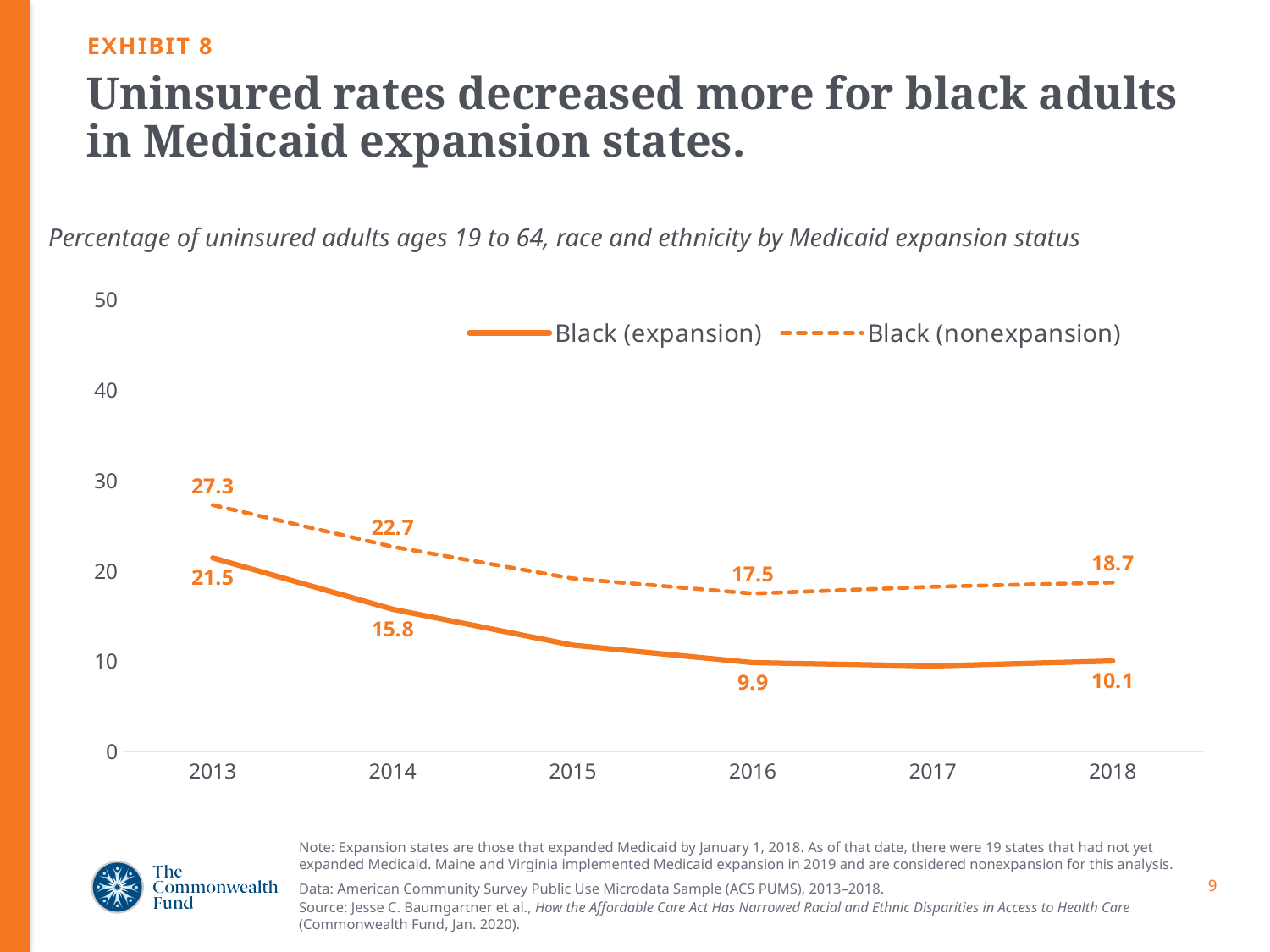
How many series does the legend list? 2 What was the uninsured rate for Black (nonexpansion) in 2014? 22.7 What was the uninsured rate for Black (nonexpansion) in 2018? 18.7 Is the value for Black (expansion) in 2015 greater or less than 20? less What was the uninsured rate for Black (expansion) in 2013? 21.5 In which year was the Black (nonexpansion) rate highest? 2013 How many years are shown on the x axis? 6 What was the uninsured rate for Black (expansion) in 2016? 9.9 What kind of chart is shown on the slide? Line chart Which series had the higher uninsured rate in 2016, Black (expansion) or Black (nonexpansion)? Black (nonexpansion) What is the difference between the Black (nonexpansion) and Black (expansion) rates in 2018? 8.6